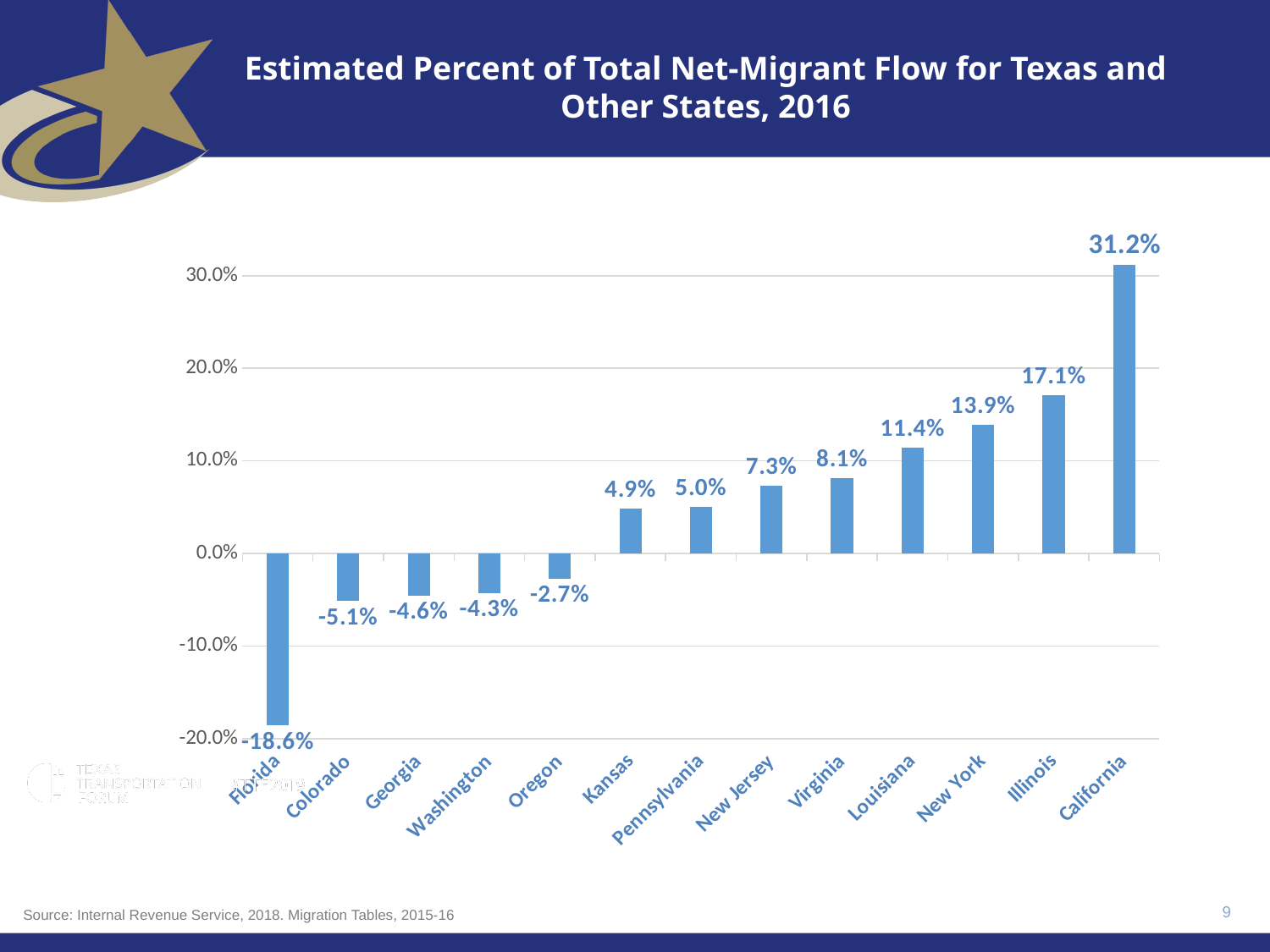
What is the difference between the values for Illinois and New York? 3.2% What kind of chart is this? bar chart How many states are shown on the chart? 13 Which state has the highest value? California Which state has the lowest value? Florida What is the title of the chart? Estimated Percent of Total Net-Migrant Flow for Texas and Other States, 2016 Is the value for California greater or less than 30.0%? greater Do the values rise or fall from left to right along the x axis? rise What is the value for Florida? -18.6% What is the value for California? 31.2% What is the value for Louisiana? 11.4% Which is larger, the value for Virginia or the value for New Jersey? Virginia